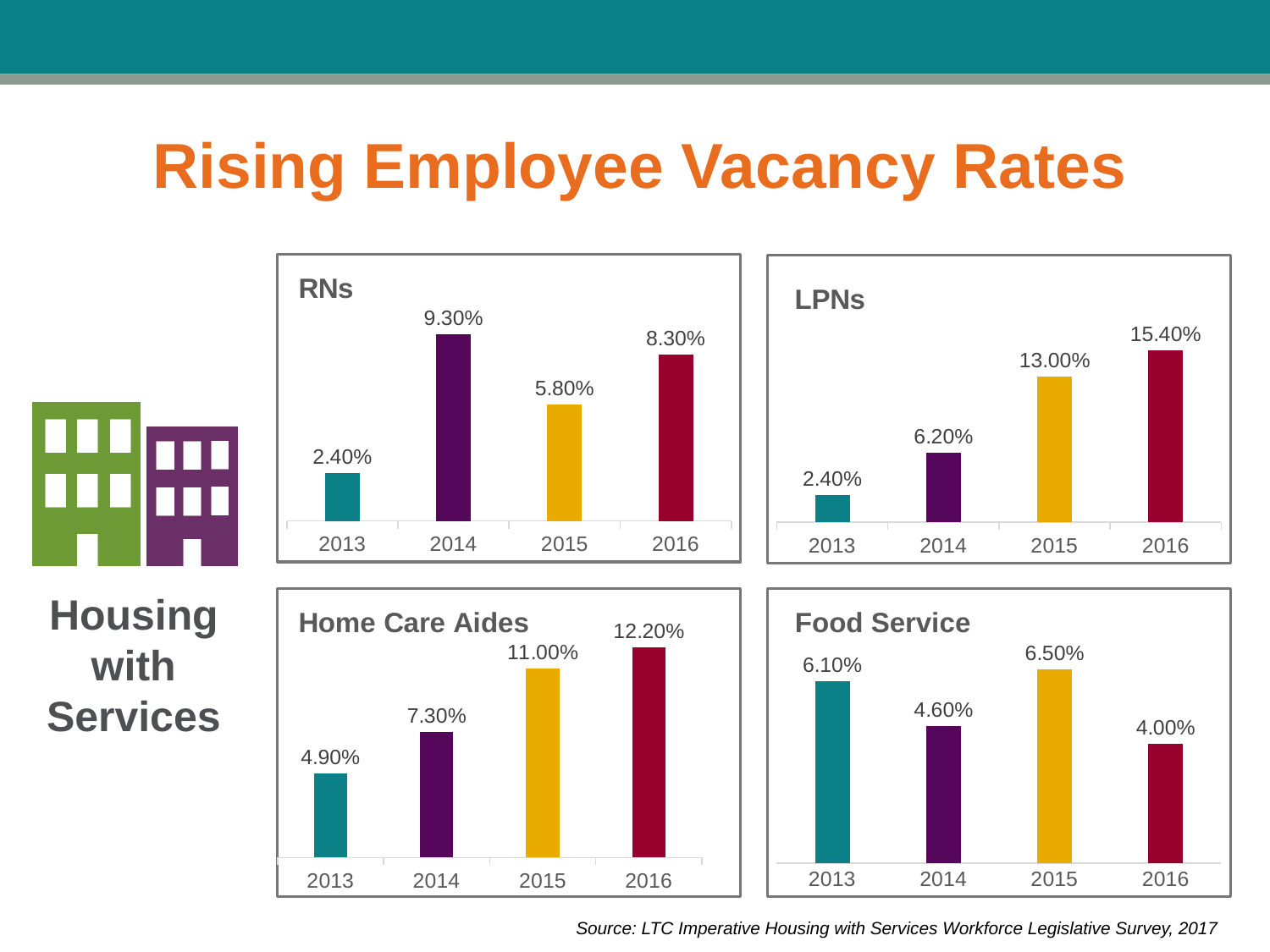
How many years are shown in the LPNs chart? 4 In the LPNs chart, which year has the highest vacancy rate? 2016 In the LPNs chart, do the values rise or fall from 2013 to 2016? Rise In the Food Service chart, what is the value for 2015? 6.50% In the RNs chart, what is the difference between the 2014 and 2013 values? 6.90% In the LPNs chart, what is the value for 2016? 15.40% In the Home Care Aides chart, what is the difference between the 2016 and 2015 values? 1.20% In the RNs chart, what is the vacancy rate for 2014? 9.30% What kind of chart is the Home Care Aides chart? Bar chart In the Food Service chart, which year has the lowest vacancy rate? 2016 In the Food Service chart, which is larger, the value for 2013 or the value for 2014? 2013 In the Home Care Aides chart, what is the value for 2013? 4.90%